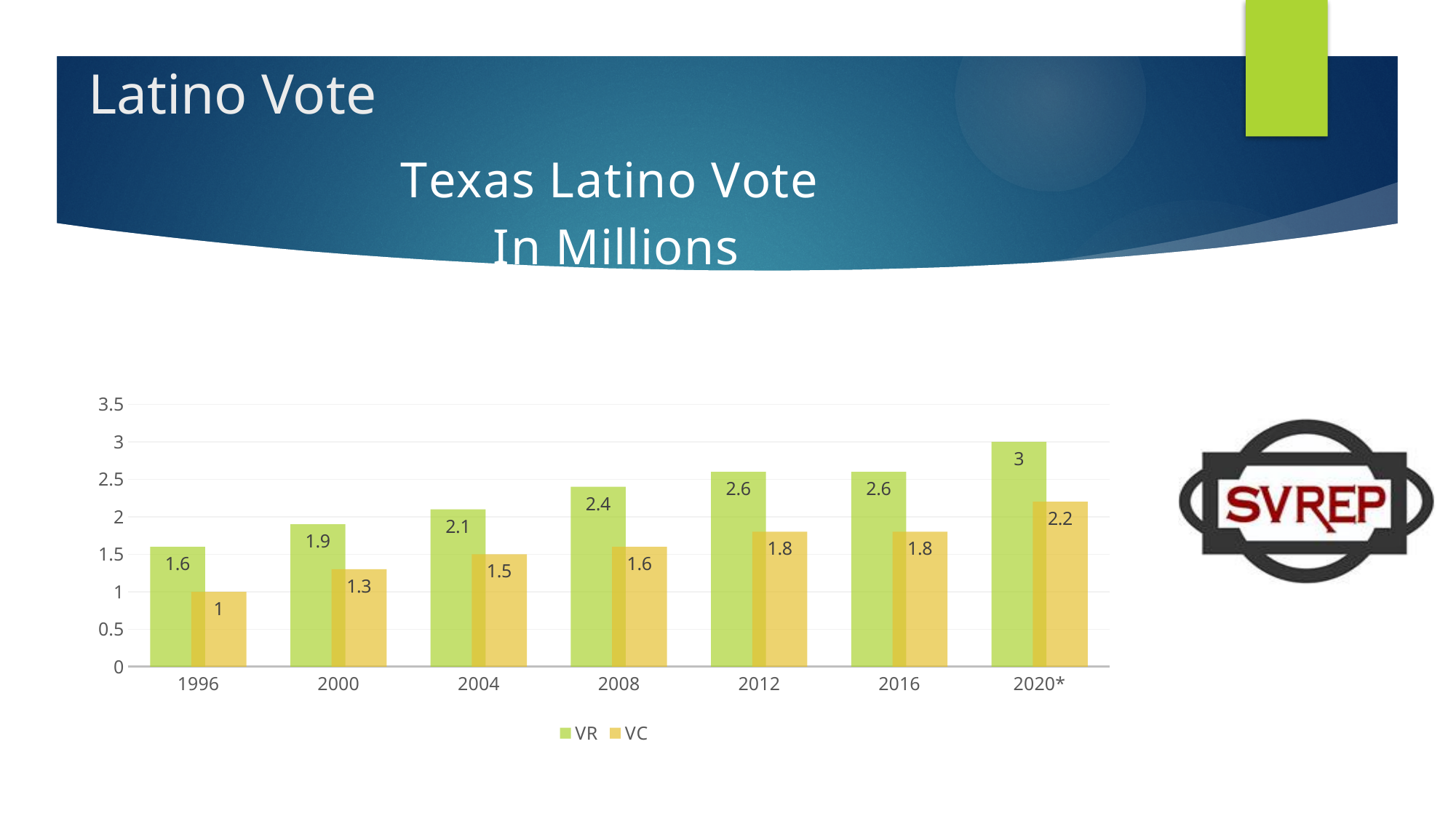
Which year has the highest VR value? 2020* What kind of chart is shown on the slide? Bar chart What is the difference between the VR and VC values in 2012? 0.8 Is the VR value for 2016 greater or less than 2.5? greater What is the VR value for 2008? 2.4 Do the VC values generally rise or fall from 1996 to 2020*? Rise How many series does the legend list? 2 What is the VC value for 2020*? 2.2 How many years are shown on the x axis? 7 What is the VC value for 2000? 1.3 Which is larger in 2004, the VR value or the VC value? VR Which year has the lowest VC value? 1996